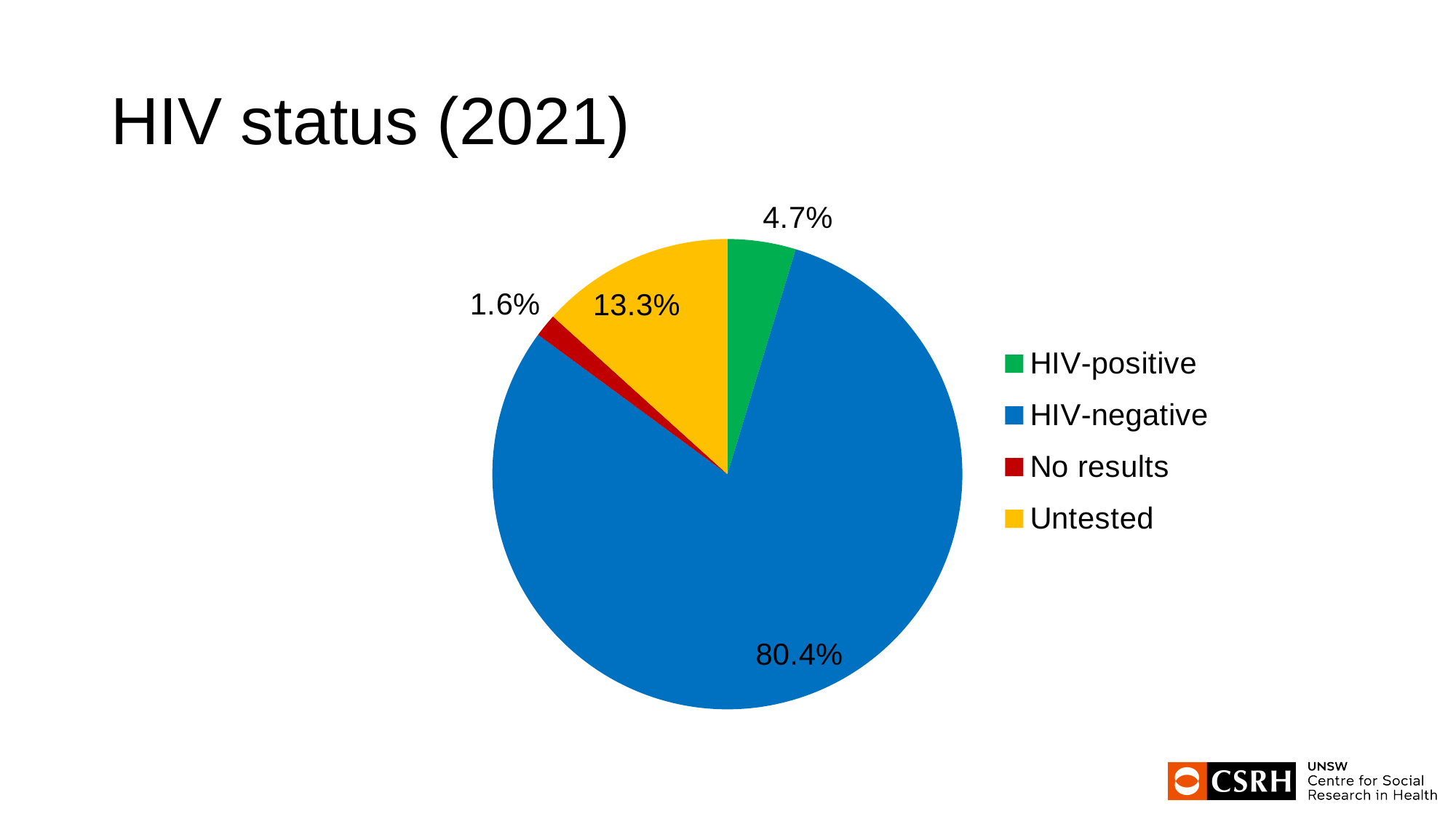
What kind of chart is shown on the slide? Pie chart Which category has the smallest share of the pie? No results What percentage of the pie is Untested? 13.3% How many categories does the pie chart have? 4 What is the title of the slide? HIV status (2021) What percentage of the pie is No results? 1.6% What is the difference in percentage points between the Untested and HIV-positive slices? 8.6 Which is larger, the HIV-positive slice or the No results slice? HIV-positive What percentage of the pie is HIV-negative? 80.4% What colour is the Untested slice? Yellow What percentage of the pie is HIV-positive? 4.7% Which category has the largest share of the pie? HIV-negative